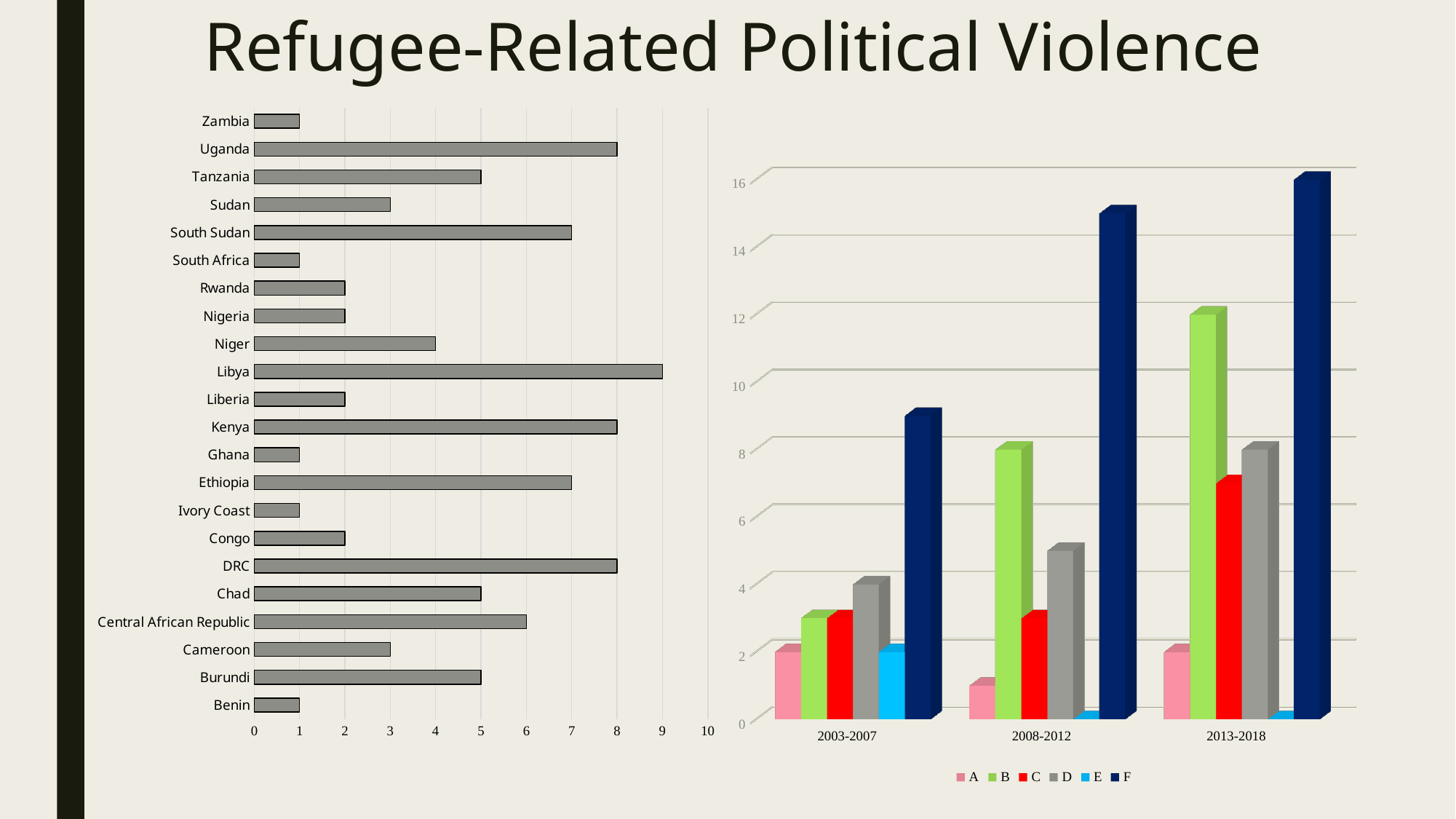
On the left chart, what is the difference between the values for Uganda and Sudan? 5 On the right chart, is the value for series A in 2013-2018 greater or less than 4? less On the left chart, what is the value for Central African Republic? 6 On the right chart, how many time periods are shown on the x axis? 3 What kind of chart is the left chart? Bar chart On the left chart, which country has the highest value? Libya On the left chart, how many countries are listed? 22 On the left chart, which has the larger value, Tanzania or Niger? Tanzania On the left chart, what is the value for Libya? 9 On the right chart, is the value for series F in 2008-2012 greater or less than 12? greater On the right chart, does the value for series B rise or fall from 2003-2007 to 2013-2018? Rise On the right chart, how many series does the legend list? 6